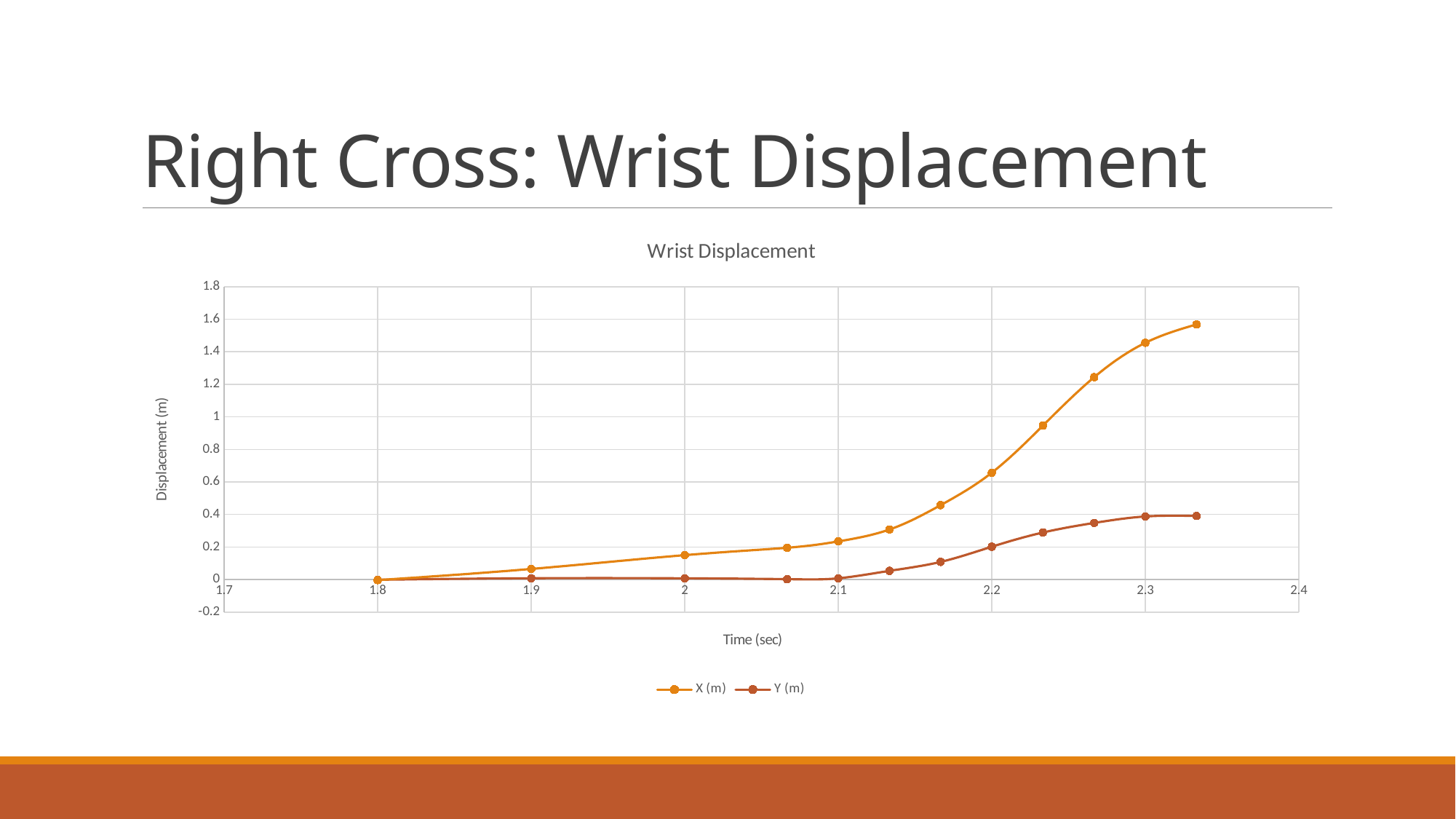
What kind of chart is shown on the slide? line chart What are the two series named in the legend? X (m) and Y (m) What is the title of the chart? Wrist Displacement Is the Y (m) value at time 2.2 greater or less than 0.4? less How many series does the legend list? 2 Is the Y (m) value at time 2.333 greater or less than 0.6? less At time 2.3, which series has the larger value, X (m) or Y (m)? X (m) Does the X (m) series generally rise or fall as time increases from 1.8 to 2.333? rise Is the X (m) value at time 2.333 greater or less than 1.4? greater